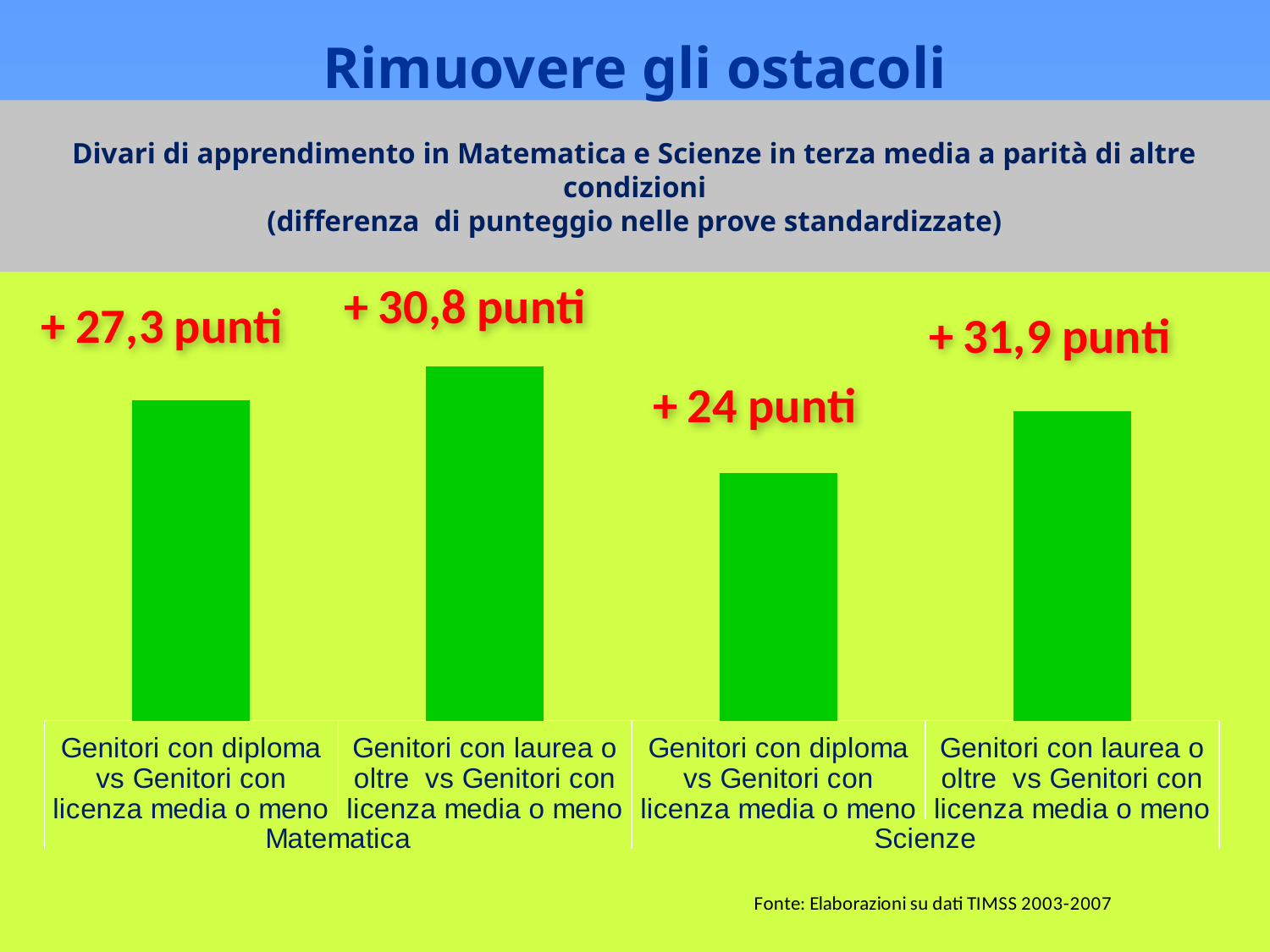
What type of chart is shown on the slide? Bar chart What is the value for 'Genitori con laurea o oltre vs Genitori con licenza media o meno' in Scienze? + 31,9 punti What is the value for 'Genitori con diploma vs Genitori con licenza media o meno' in Matematica? + 27,3 punti How many bars are shown in the chart? 4 What is the difference between the two Matematica bars (laurea o oltre minus diploma)? 3,5 punti What is the source cited below the chart? Elaborazioni su dati TIMSS 2003-2007 What is the value for 'Genitori con diploma vs Genitori con licenza media o meno' in Scienze? + 24 punti Which is larger: the diploma gap in Matematica or the diploma gap in Scienze? Matematica What is the difference between the two Scienze bars (laurea o oltre minus diploma)? 7,9 punti What is the value for 'Genitori con laurea o oltre vs Genitori con licenza media o meno' in Matematica? + 30,8 punti Which bar has the lowest value? Genitori con diploma vs Genitori con licenza media o meno (Scienze)